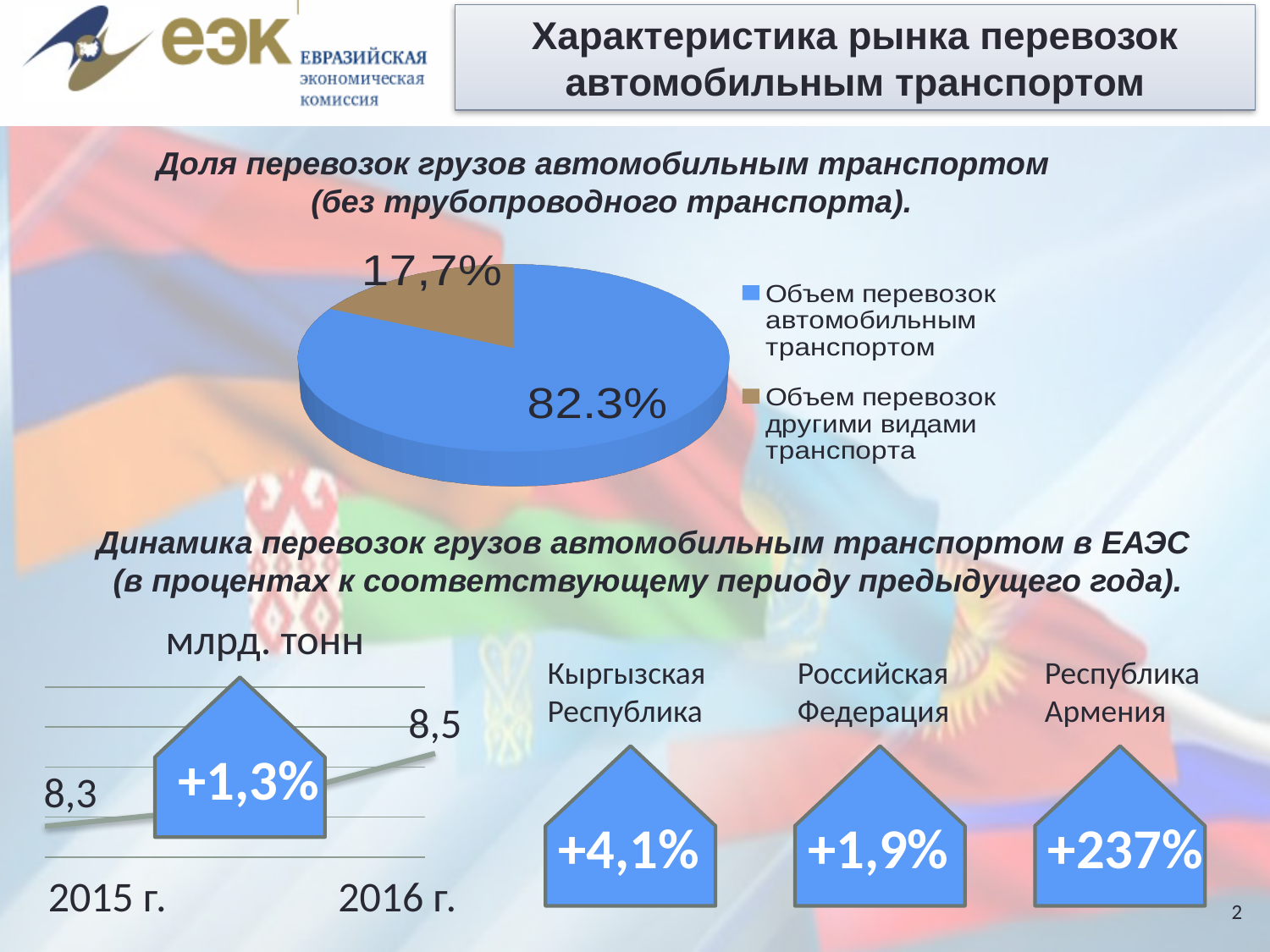
On the lower-left line chart, what is the difference between the 2016 г. and 2015 г. values? 0,2 On the lower-left line chart, what is the value for 2015 г.? 8,3 What kind of chart is the upper chart on the slide? Pie chart How many slices does the pie chart have? 2 On the lower-left line chart, what is the value for 2016 г.? 8,5 On the pie chart, which slice is the largest? Объем перевозок автомобильным транспортом On the lower-left line chart, does the value rise or fall from 2015 г. to 2016 г.? Rise What unit is shown above the lower-left line chart? млрд. тонн On the pie chart, which colour represents 'Объем перевозок другими видами транспорта'? Brown On the pie chart, which slice is the smallest? Объем перевозок другими видами транспорта On the pie chart, what share is shown for 'Объем перевозок автомобильным транспортом'? 82.3% On the pie chart, what share is shown for 'Объем перевозок другими видами транспорта'? 17,7%